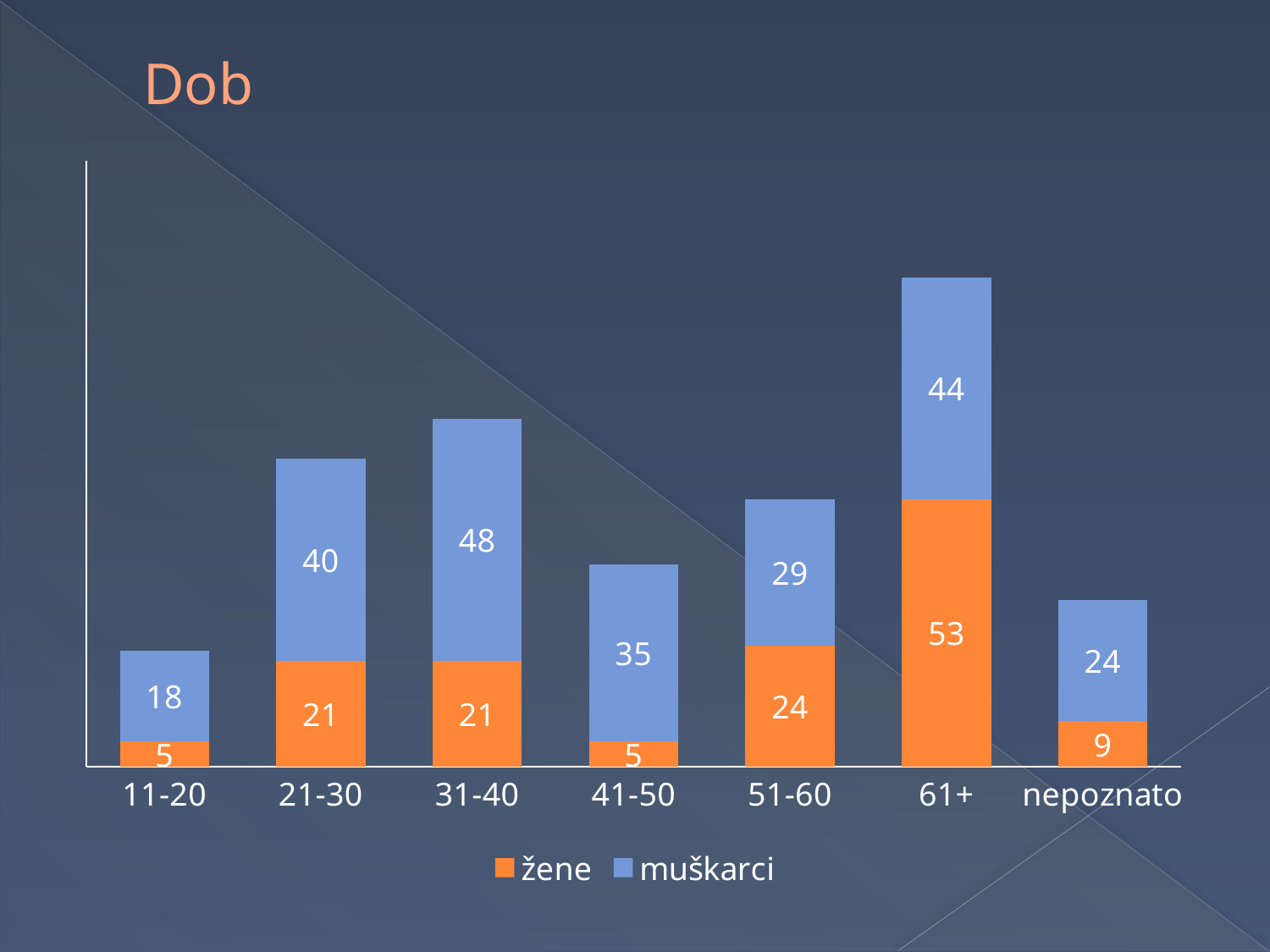
Which category has the highest value for muškarci? 31-40 What is the title of the chart? Dob How many series does the legend list? 2 What is the value for žene in the nepoznato category? 9 Which is larger, the žene value for 51-60 or the žene value for 31-40? 51-60 What is the total of the stacked bar for the 61+ category? 97 What is the value for muškarci in the 31-40 category? 48 What is the value for žene in the 61+ category? 53 What is the difference between the muškarci values for 21-30 and 51-60? 11 How many age categories are shown on the x axis? 7 Which category has the lowest value for muškarci? 11-20 What kind of chart is shown on the slide? stacked bar chart